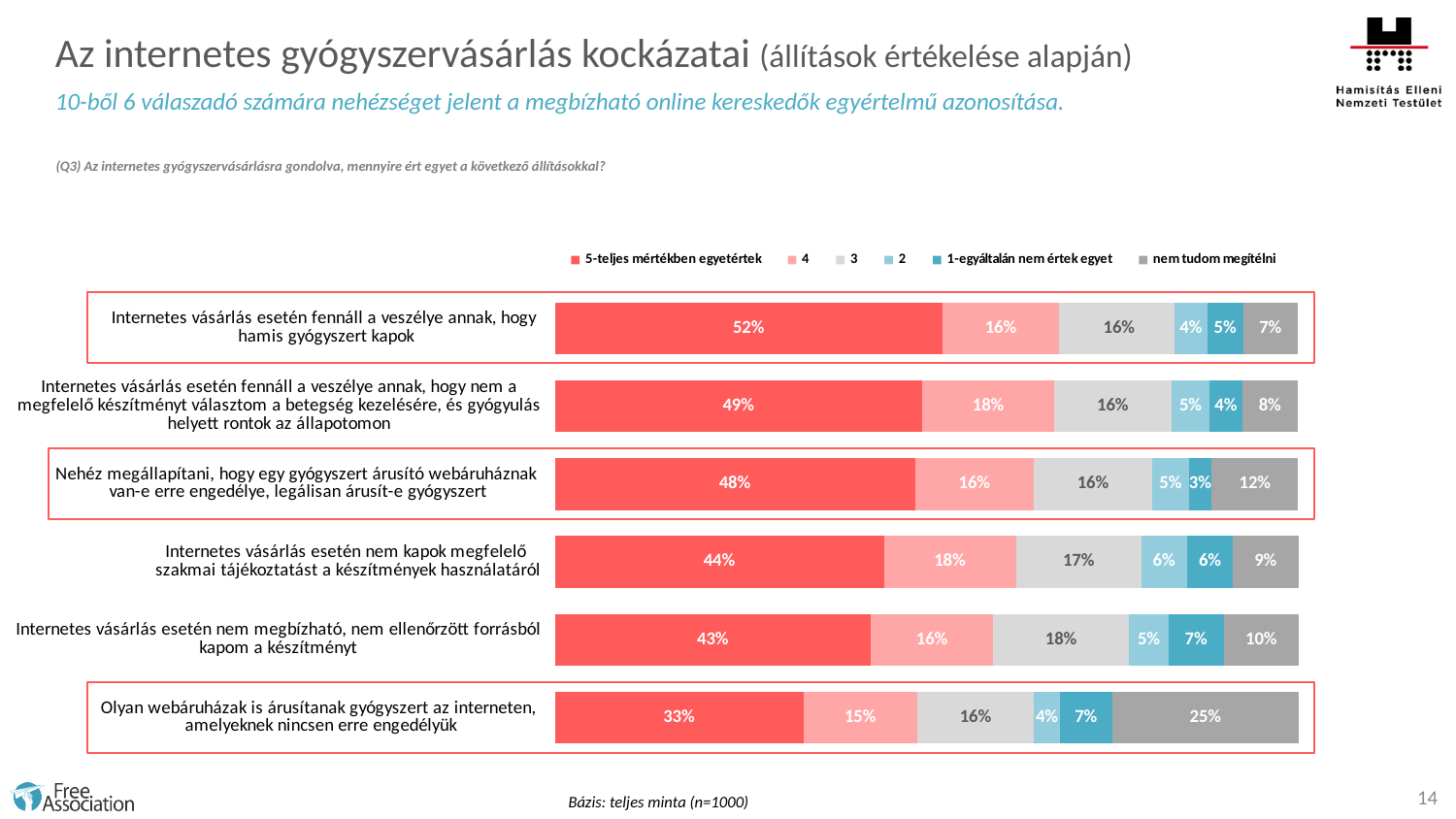
Which statement has the highest '5-teljes mértékben egyetértek' value? Internetes vásárlás esetén fennáll a veszélye annak, hogy hamis gyógyszert kapok What is the value of '5-teljes mértékben egyetértek' for the statement 'Internetes vásárlás esetén fennáll a veszélye annak, hogy hamis gyógyszert kapok'? 52% What kind of chart is shown on the slide? Stacked bar chart What is the difference between the '5-teljes mértékben egyetértek' values for 'Internetes vásárlás esetén fennáll a veszélye annak, hogy hamis gyógyszert kapok' and 'Olyan webáruházak is árusítanak gyógyszert az interneten, amelyeknek nincsen erre engedélyük'? 19% How many statements (categories) are plotted in the chart? 6 What is the value of 'nem tudom megítélni' for the statement 'Olyan webáruházak is árusítanak gyógyszert az interneten, amelyeknek nincsen erre engedélyük'? 25% What is the total of the stacked bar for 'Internetes vásárlás esetén fennáll a veszélye annak, hogy hamis gyógyszert kapok'? 100% Which is larger: the '4' value for 'Internetes vásárlás esetén nem kapok megfelelő szakmai tájékoztatást a készítmények használatáról' or the '4' value for 'Olyan webáruházak is árusítanak gyógyszert az interneten, amelyeknek nincsen erre engedélyük'? Internetes vásárlás esetén nem kapok megfelelő szakmai tájékoztatást a készítmények használatáról How many series does the legend list? 6 Which statement has the lowest '5-teljes mértékben egyetértek' value? Olyan webáruházak is árusítanak gyógyszert az interneten, amelyeknek nincsen erre engedélyük What is the value of '1-egyáltalán nem értek egyet' for the statement 'Nehéz megállapítani, hogy egy gyógyszert árusító webáruháznak van-e erre engedélye, legálisan árusít-e gyógyszert'? 3% What is the first entry in the chart's legend? 5-teljes mértékben egyetértek